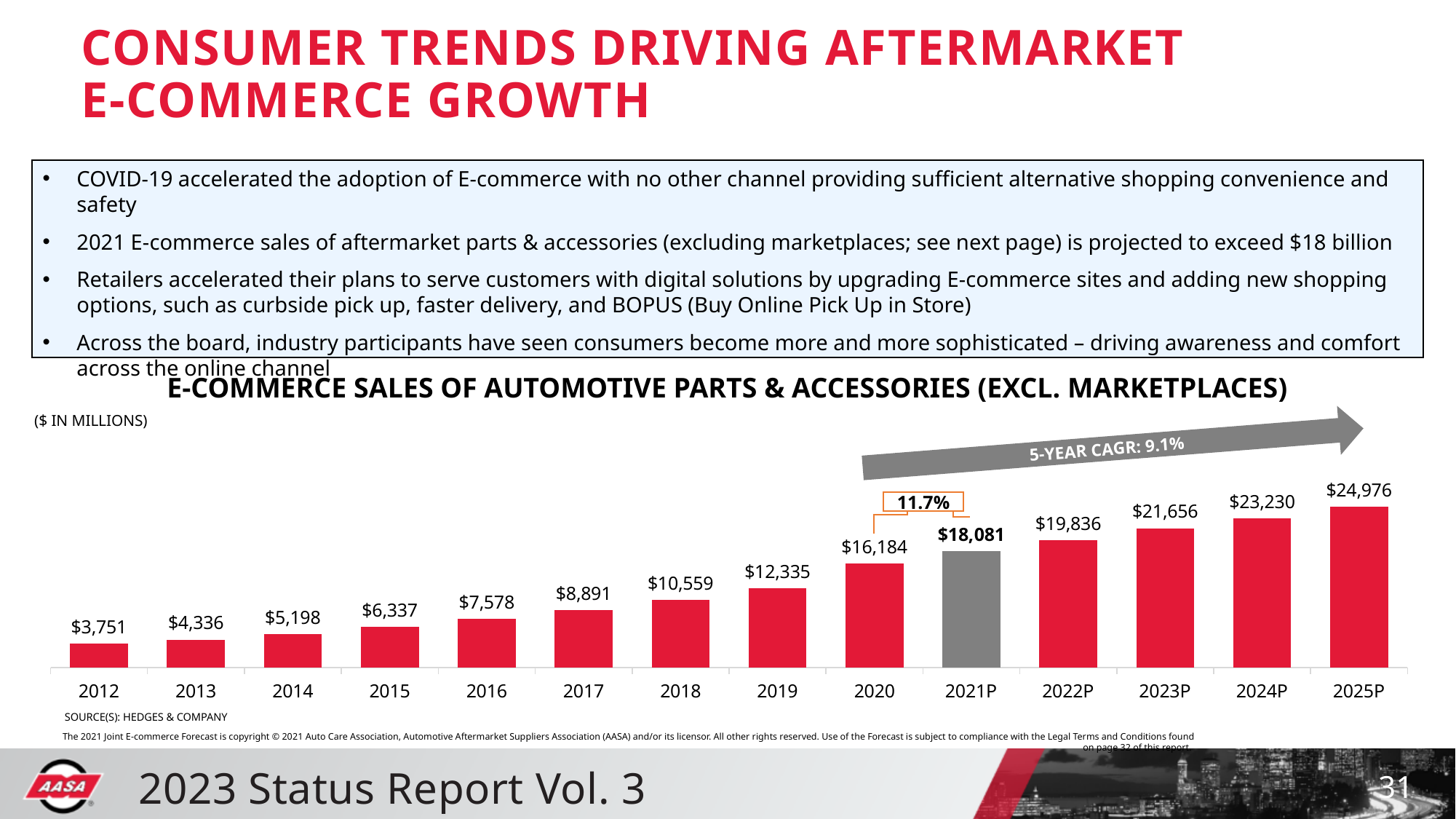
What is the value for 2018? $10,559 Which year has the lowest value? 2012 Do the values rise or fall from 2012 to 2025P? Rise What is the value for 2012? $3,751 What kind of chart is shown? Bar chart Which year has the highest value? 2025P What is the value for 2025P? $24,976 What is the difference between the values for 2020 and 2019? $3,849 What is the difference between the values for 2025P and 2024P? $1,746 What is the value for 2021P? $18,081 Which is larger, the value for 2016 or the value for 2017? 2017 How many years are shown on the x axis? 14